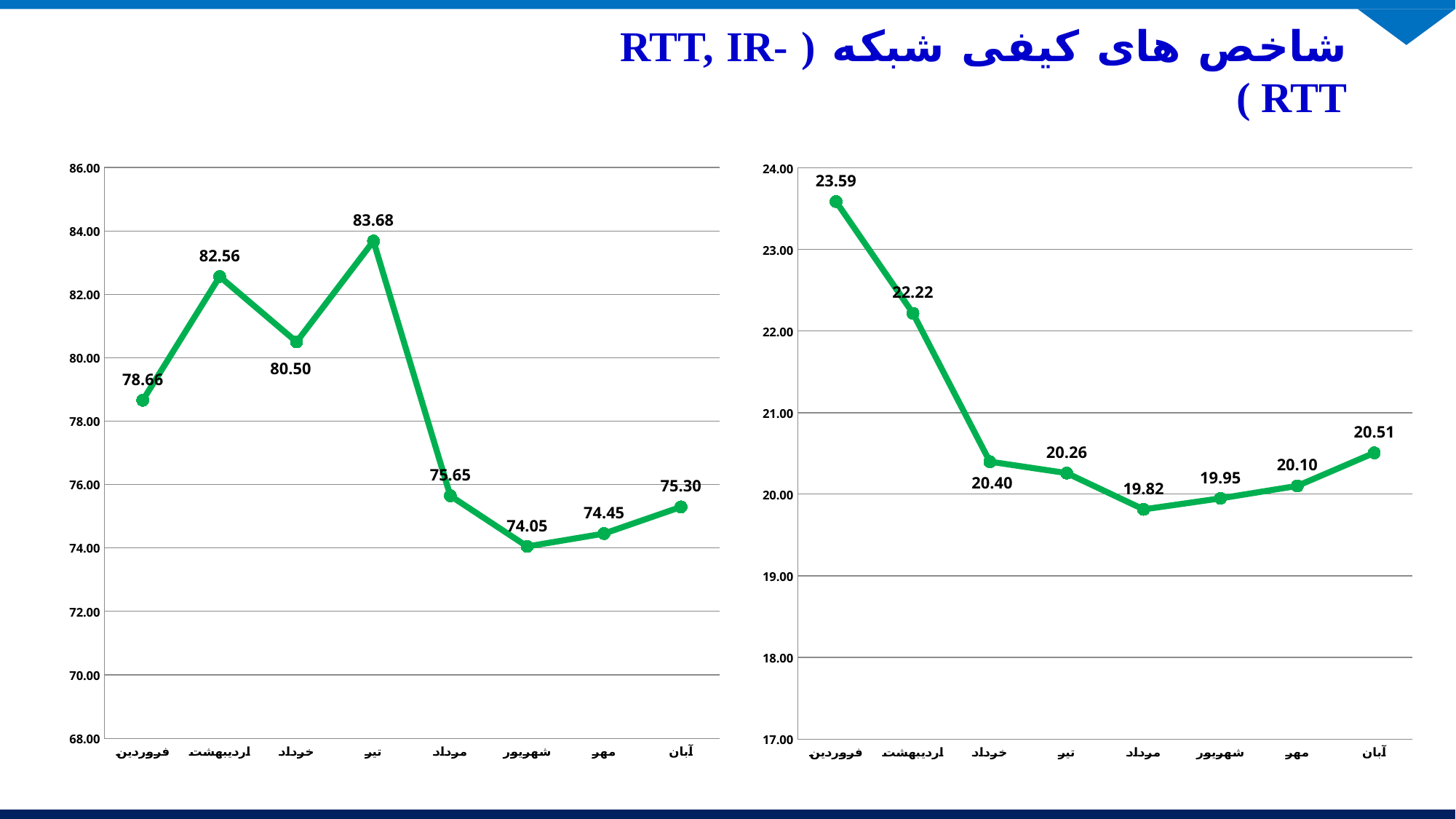
On the left chart, what is the difference between the values for تیر and شهریور? 9.63 On the left chart, which month has the lowest value? شهریور On the right chart, is the value for اردیبهشت greater or less than 22.00? greater On the left chart, which is larger, the value for اردیبهشت or the value for خرداد? اردیبهشت On the right chart, which month has the highest value? فروردین On the right chart, which month has the lowest value? مرداد On the right chart, what is the difference between the values for فروردین and آبان? 3.08 What kind of chart is the right chart? line chart On the left chart, what is the value for تیر? 83.68 On the right chart, what is the value for فروردین? 23.59 On the right chart, do the values rise or fall from فروردین to خرداد? fall How many months are plotted on the left chart? 8